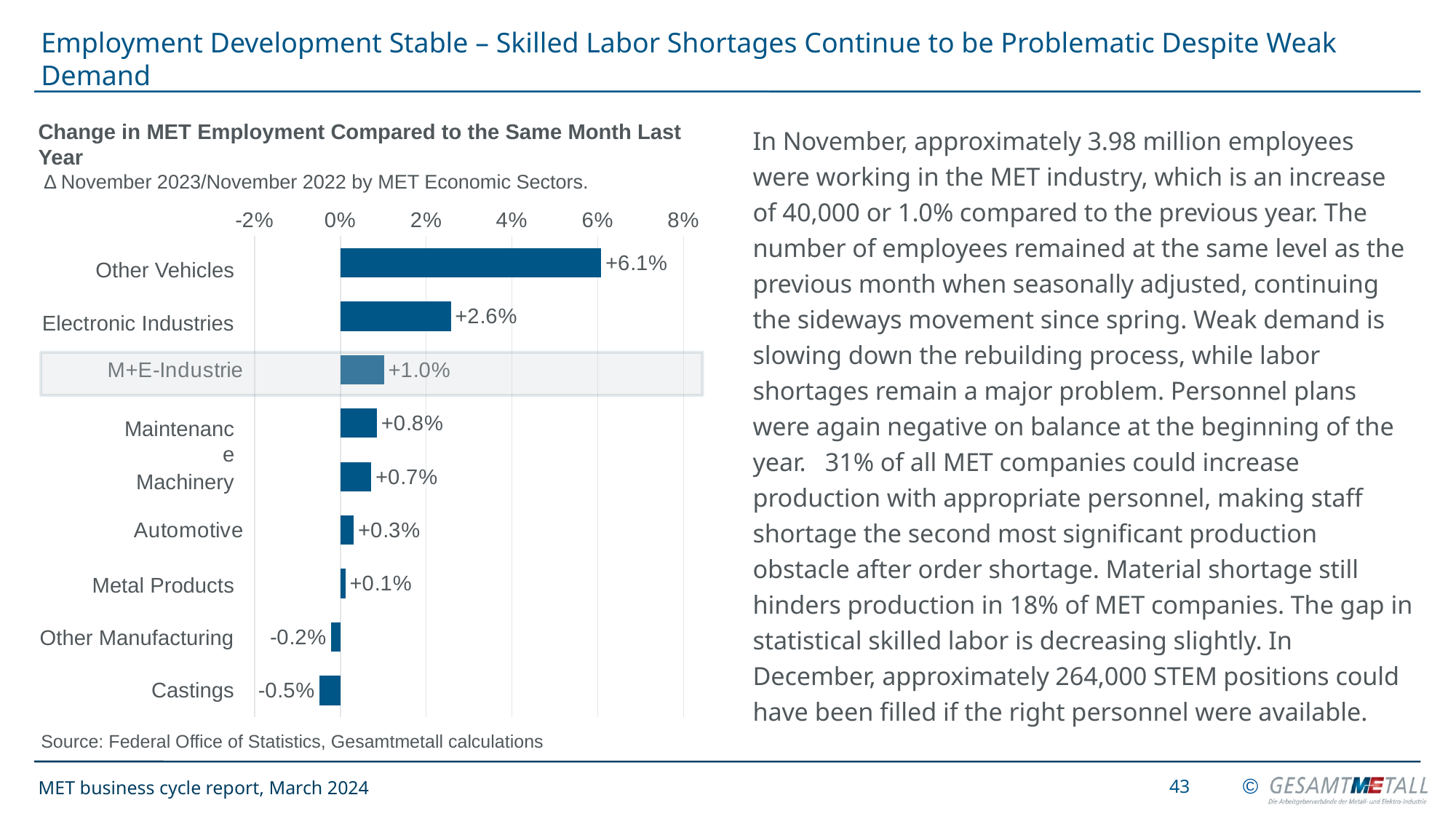
How many sectors show a negative change in employment? 2 Which sector has the lowest change in employment? Castings What is the source given for the chart? Federal Office of Statistics, Gesamtmetall calculations How many sectors are shown in the chart? 9 What is the difference between the values for Other Vehicles and Electronic Industries? 3.5 percentage points Which sector has the highest change in employment? Other Vehicles What is the change in employment for Electronic Industries? +2.6% Which has a larger change in employment, Machinery or Automotive? Machinery What is the change in employment for Castings? -0.5% What is the change in employment for M+E-Industrie? +1.0% What kind of chart is shown on the slide? Bar chart What is the change in employment for Other Vehicles? +6.1%